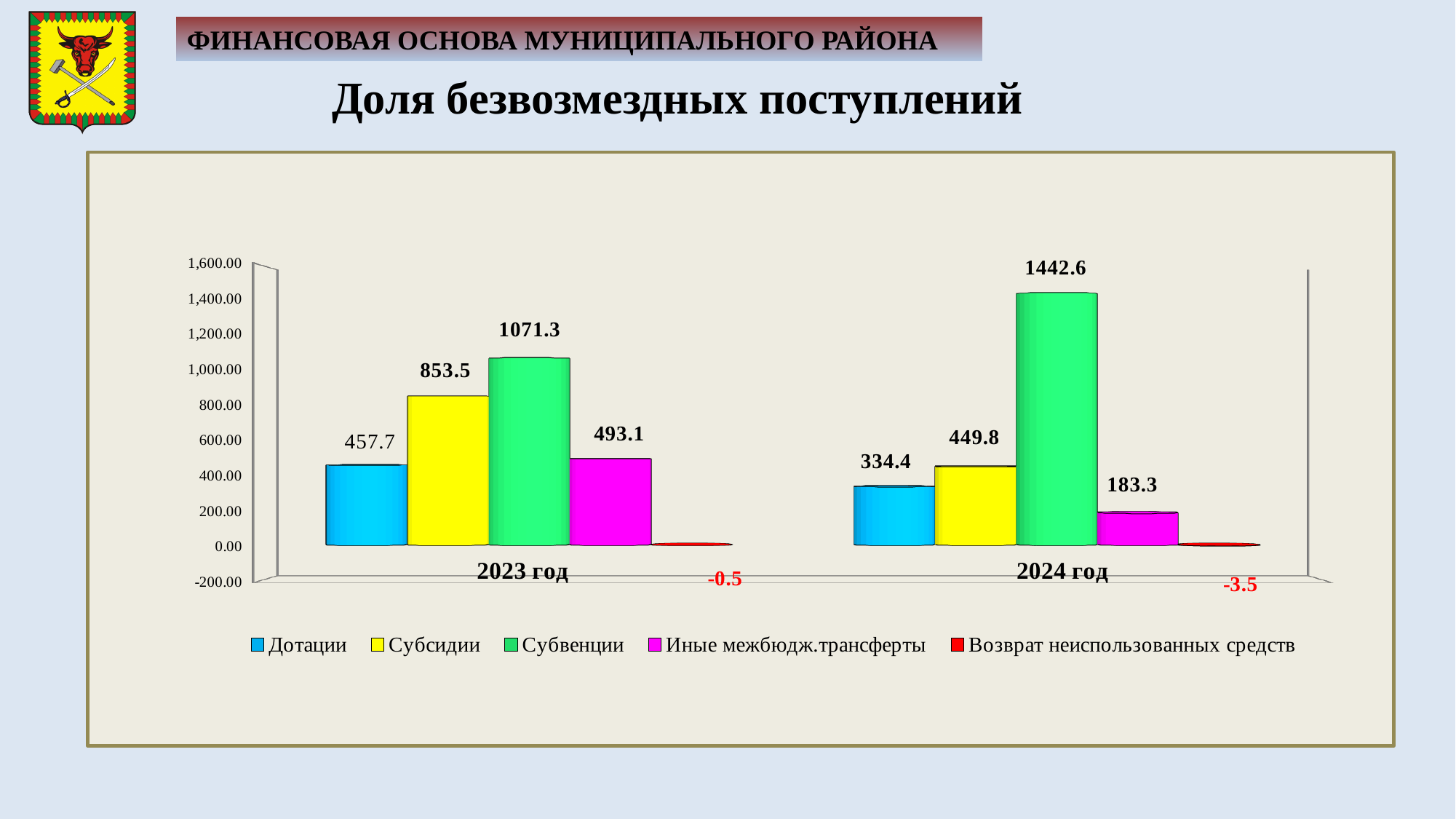
Which series has the lowest value for 2024 год? Возврат неиспользованных средств What is the difference between Субсидии in 2023 год and Субсидии in 2024 год? 403.7 Which is larger: Дотации in 2023 год or Дотации in 2024 год? Дотации in 2023 год How does the value of Иные межбюдж.трансферты change from 2023 год to 2024 год? It falls What kind of chart is shown on the slide? Bar chart What is the value of Возврат неиспользованных средств for 2024 год? -3.5 Which series has the highest value for 2023 год? Субвенции What is the value of Субвенции for 2024 год? 1442.6 What colour represents Субвенции in the legend? Green What is the value of Дотации for 2023 год? 457.7 What is the value of Иные межбюдж.трансферты for 2023 год? 493.1 How many series does the legend list? 5